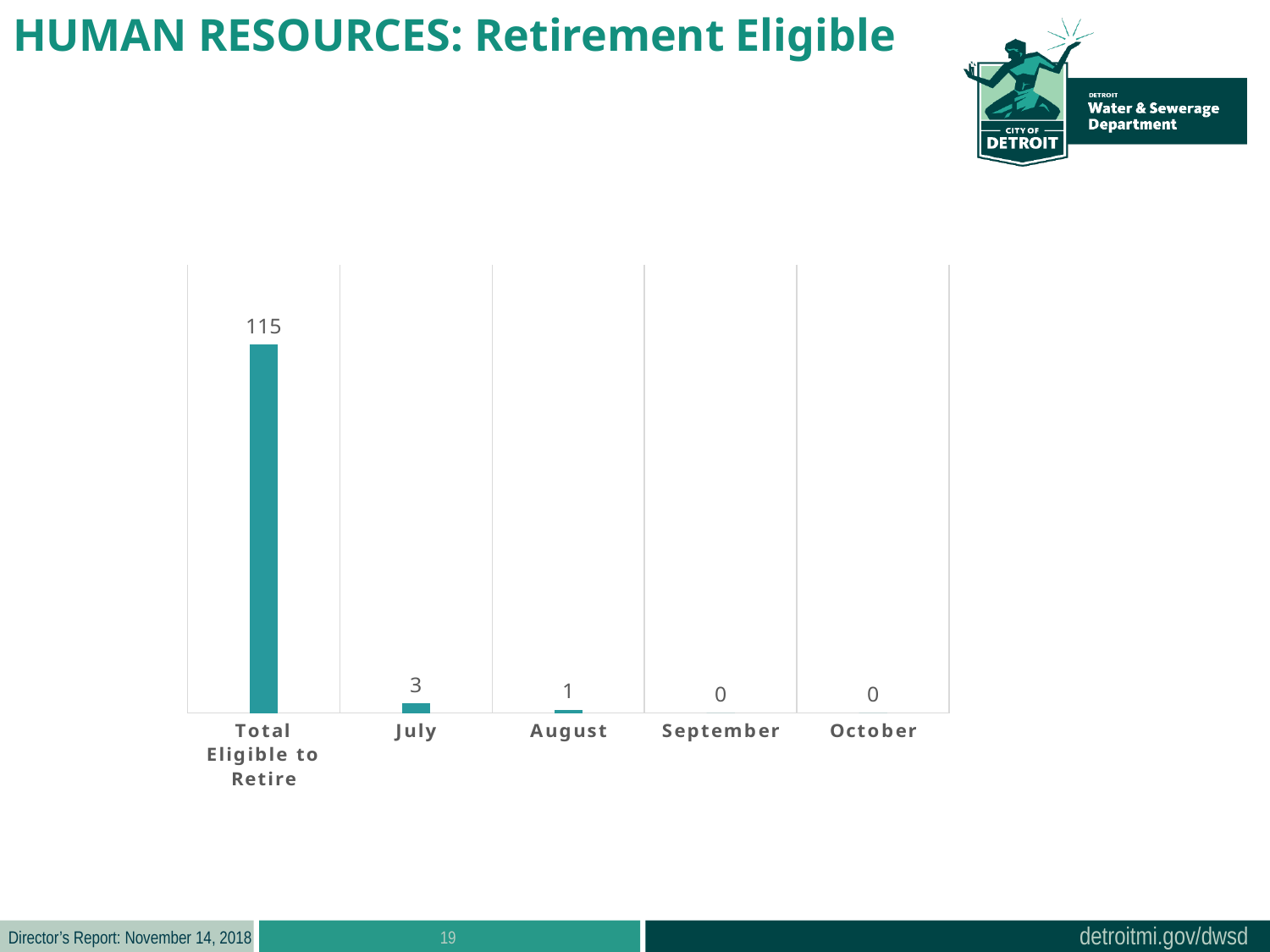
What is the difference between the values for July and August? 2 Which category has the highest value? Total Eligible to Retire What is the value for Total Eligible to Retire? 115 How many categories are shown on the x axis? 5 What kind of chart is shown on the slide? Bar chart What is the value for July? 3 What is the difference between the values for Total Eligible to Retire and July? 112 What is the value for September? 0 Do the values rise or fall from July to October? Fall Which is larger, the value for July or the value for August? July What is the value for August? 1 What is the value for October? 0